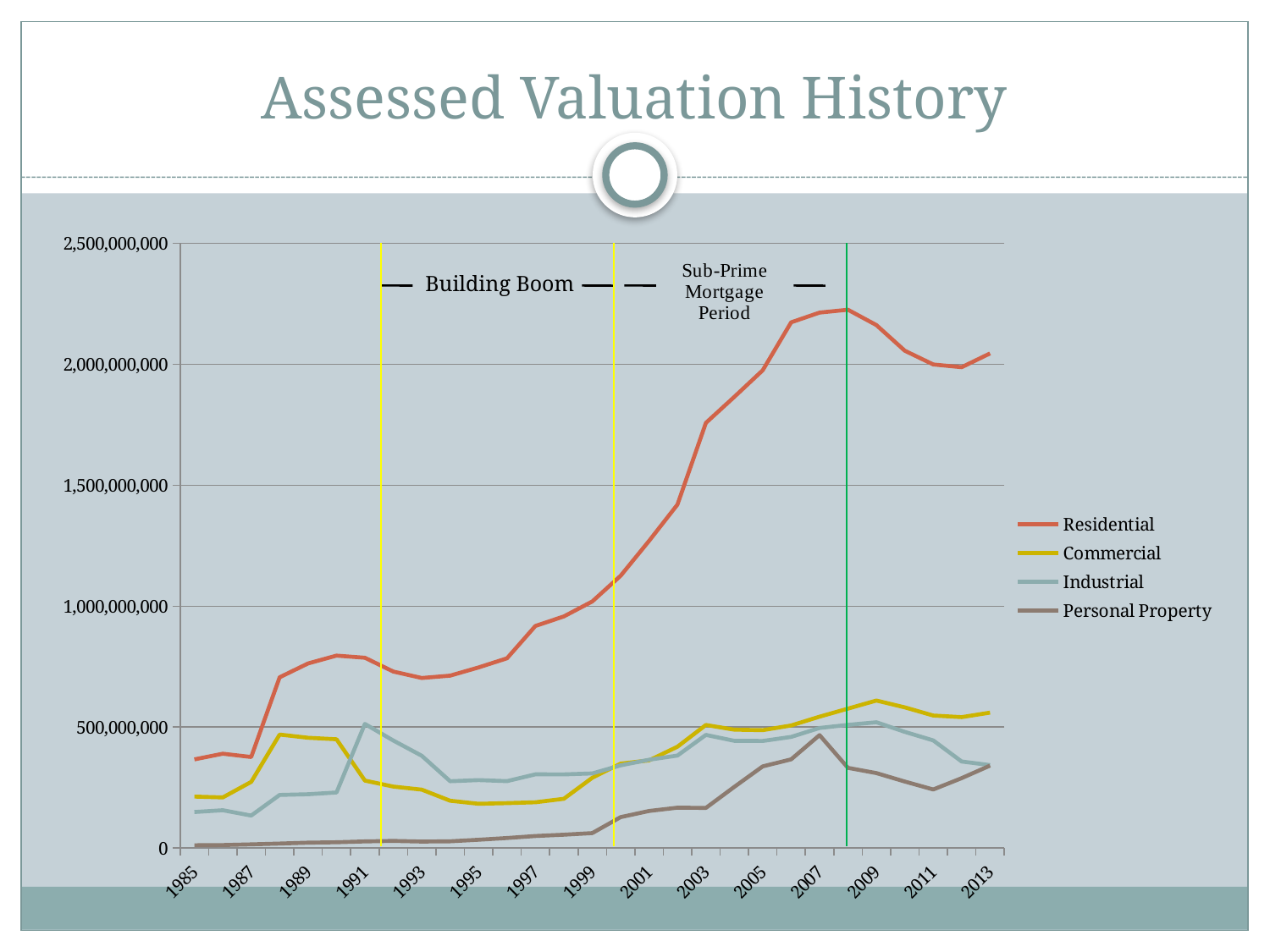
Is the Residential value for 1985 greater or less than 500,000,000? less Does the Residential series rise or fall between 2008 and 2012? Fall How many series does the legend list? 4 What kind of chart is shown on the slide? Line chart What is the title of the chart on the slide? Assessed Valuation History Which series has the lowest value in 1985? Personal Property Which series has the highest value in 2013? Residential Does the Residential series rise or fall between 2001 and 2008? Rise Is the Commercial value for 2013 greater or less than 500,000,000? greater In 2013, which is larger, the Commercial value or the Industrial value? Commercial Which two periods are labelled with annotations on the chart? Building Boom and Sub-Prime Mortgage Period Is the Residential value for 2009 greater or less than 2,000,000,000? greater